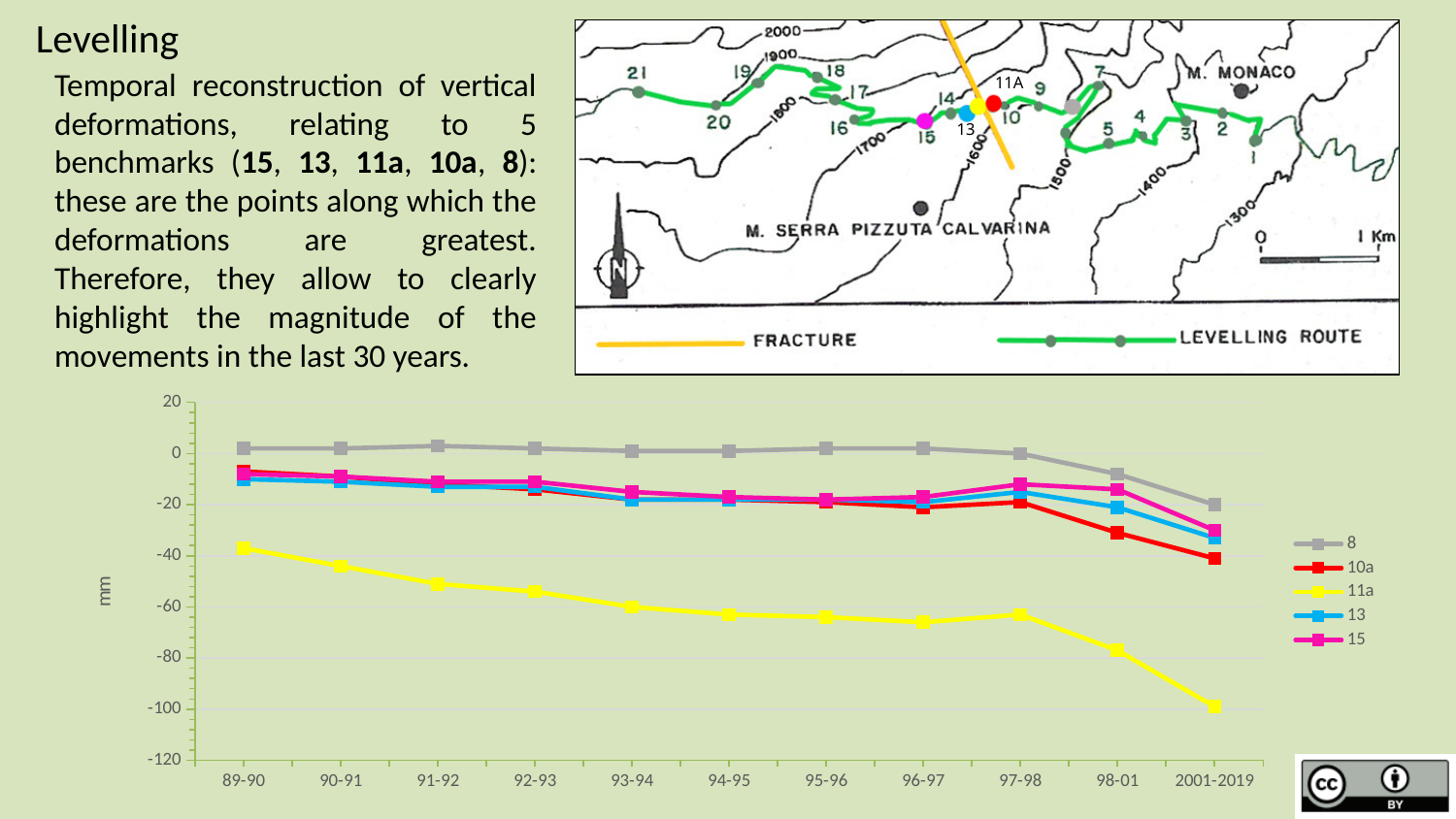
What unit is shown on the y axis of the chart? mm Is the value for series 10a at 98-01 greater or less than -20? less Which benchmark series has the highest value at 2001-2019? 8 At 2001-2019, which is larger, the value for series 13 or the value for series 10a? 13 Which benchmark series has the lowest value at 2001-2019? 11a Is the value for series 11a at 89-90 greater or less than -60? greater Does the value for series 11a rise or fall from 89-90 to 2001-2019? fall What kind of chart is shown on the slide? line chart How many periods are shown along the x axis of the chart? 11 Is the value for series 11a at 98-01 greater or less than -60? less How many series does the chart legend list? 5